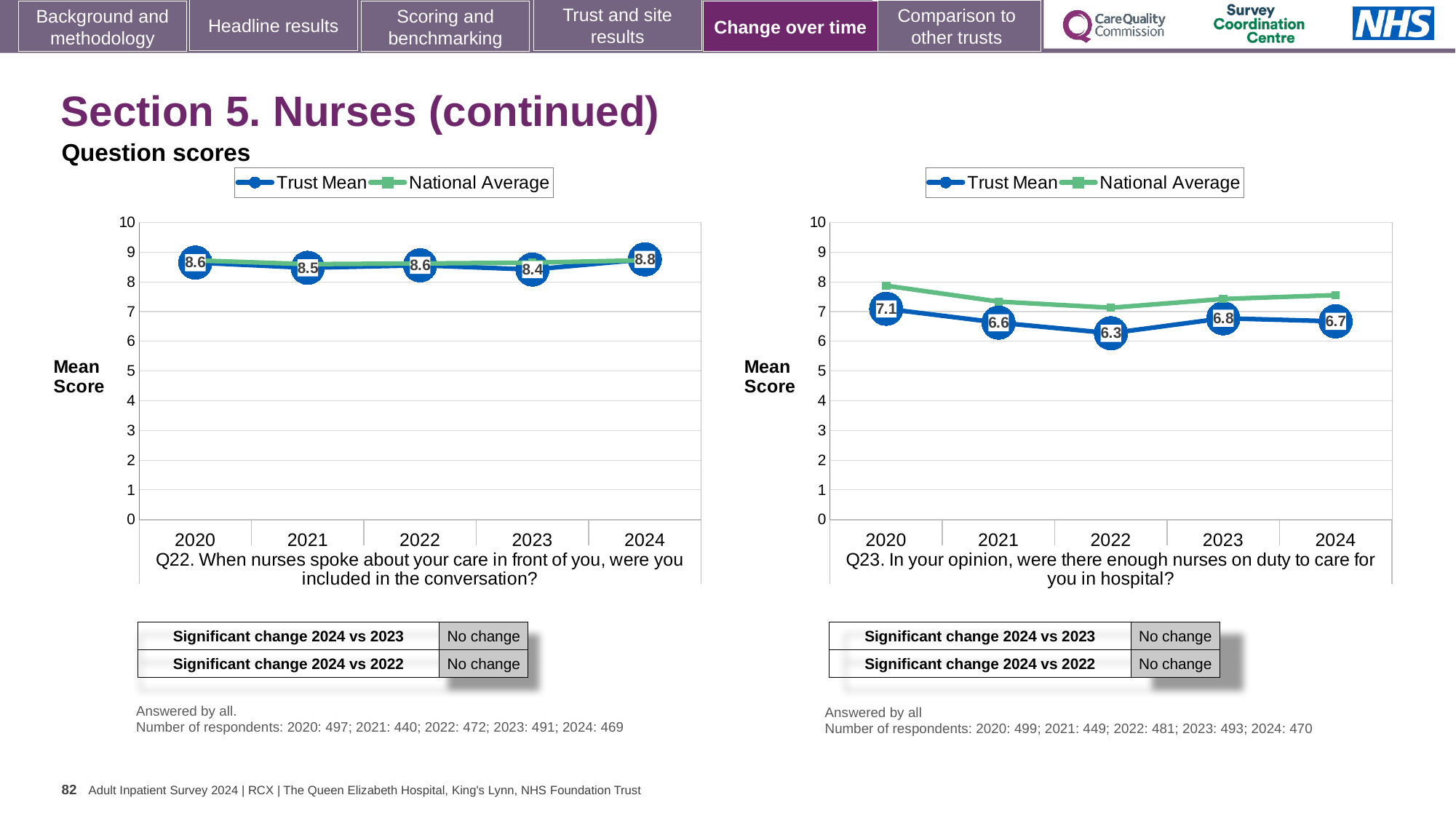
In the Q23 chart (right), is the National Average for 2020 greater or less than 7? greater In the Q22 chart (left), which year has the highest Trust Mean score? 2024 In the Q22 chart (left), is the Trust Mean score higher in 2021 or in 2023? 2021 In the Q23 chart (right), does the Trust Mean rise or fall from 2020 to 2022? Fall What are the two series named in the legend of the Q22 chart (left)? Trust Mean and National Average How many years are plotted on the x axis of the Q22 chart (left)? 5 What kind of chart is used for Q22 (left)? Line chart In the Q23 chart (right), what is the difference between the Trust Mean scores for 2020 and 2022? 0.8 In the Q23 chart (right), which year has the lowest Trust Mean score? 2022 In the Q23 chart (right), what is the Trust Mean score for 2022? 6.3 In the Q22 chart (left), what is the Trust Mean score for 2024? 8.8 How many series does the legend of the Q23 chart (right) list? 2